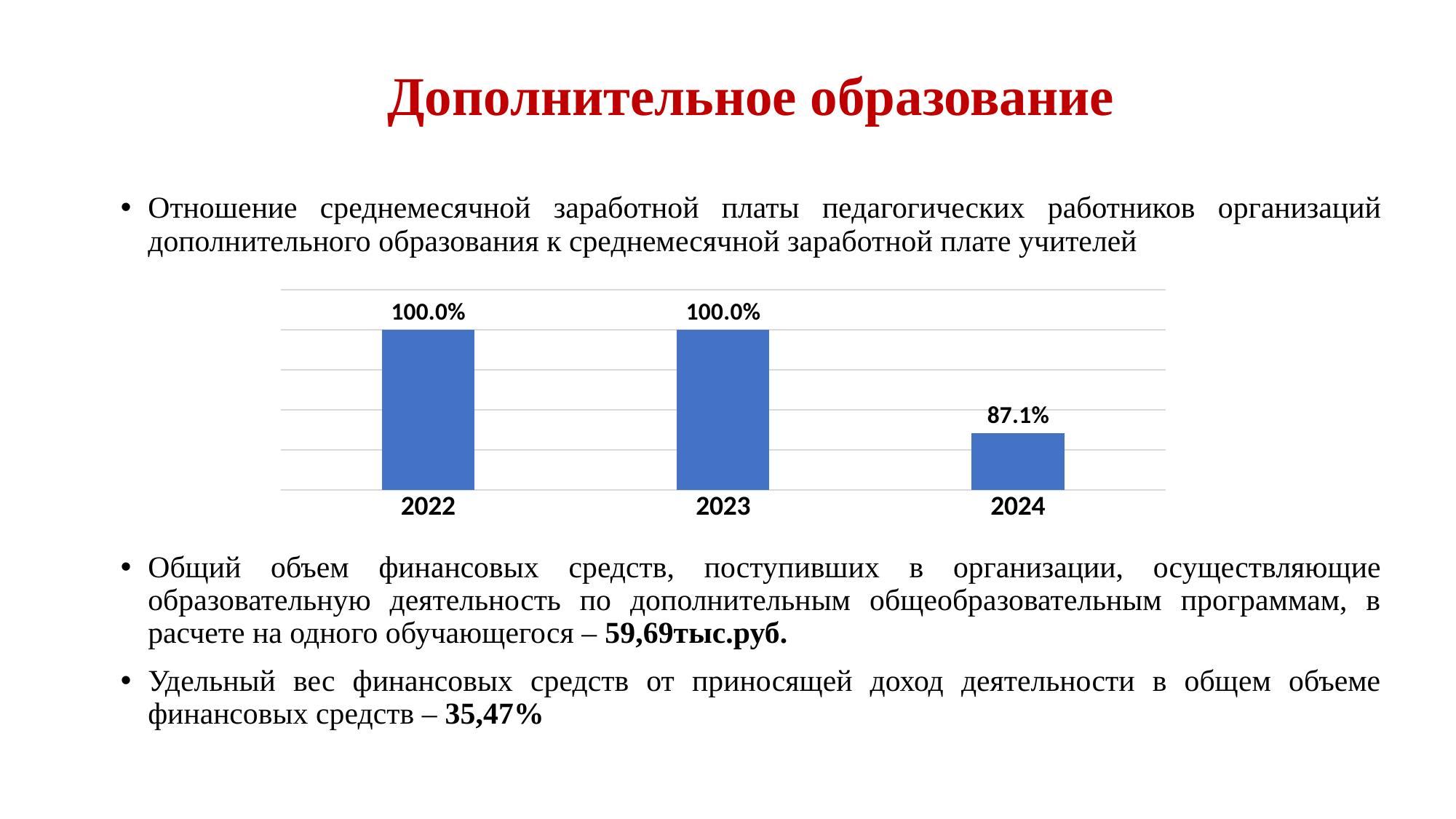
What is the value for 2024? 87.1% What colour are the bars in the chart? Blue What is the difference between the values for 2023 and 2024? 12.9% What is the value for 2023? 100.0% Which years share the highest value on the chart? 2022 and 2023 How many years are shown on the chart? 3 Which is larger, the value for 2022 or the value for 2024? 2022 What is the value for 2022? 100.0% What kind of chart is shown on the slide? Bar chart Do the values rise or fall from 2023 to 2024? Fall Which year has the lowest value? 2024 Are the values for 2022 and 2023 equal? Yes